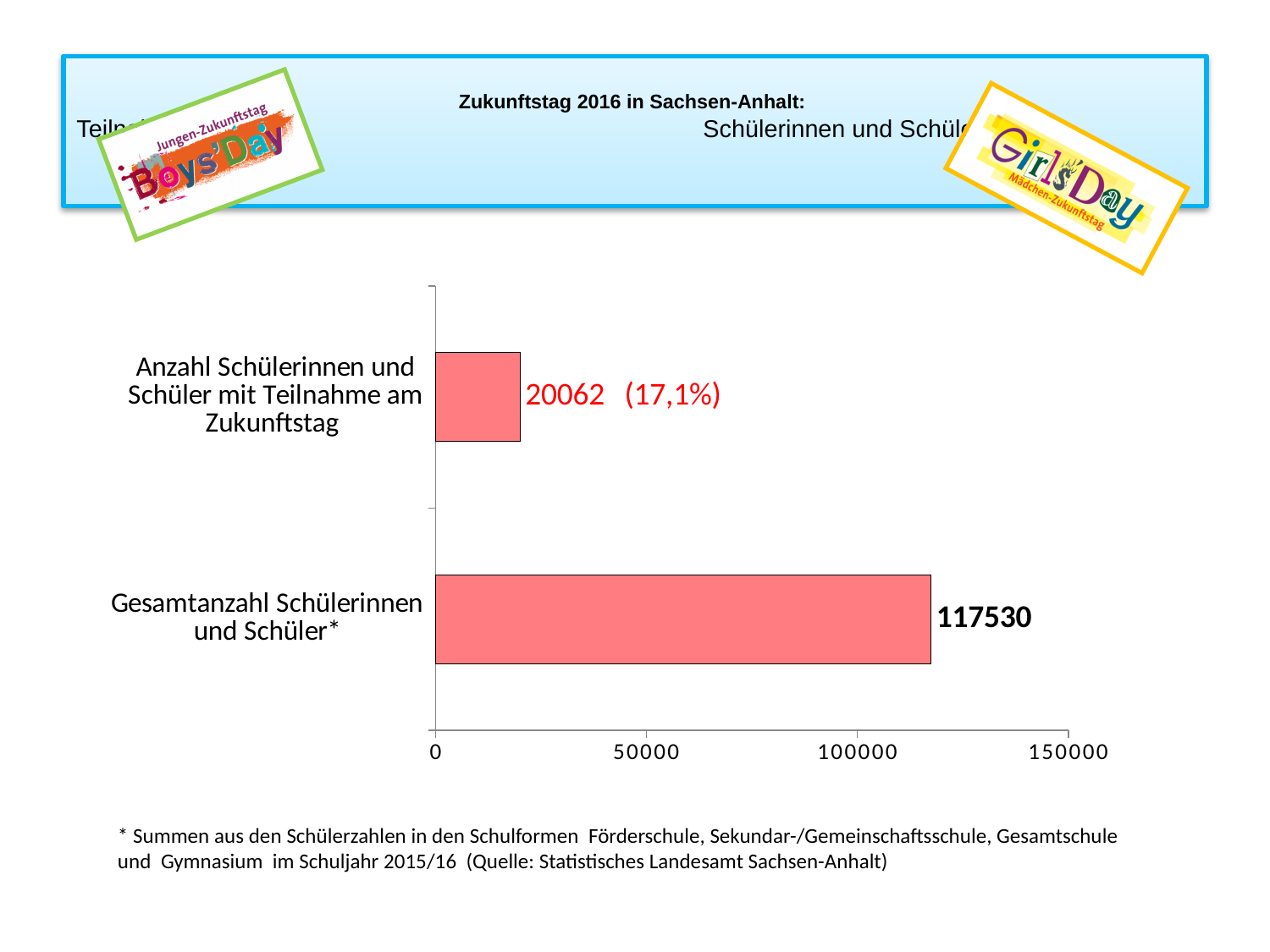
Which category has the highest value? Gesamtanzahl Schülerinnen und Schüler* What is the highest value shown on the horizontal axis of the chart? 150000 What is the value for "Gesamtanzahl Schülerinnen und Schüler*"? 117530 What is the value for "Anzahl Schülerinnen und Schüler mit Teilnahme am Zukunftstag"? 20062 Which category has the lowest value? Anzahl Schülerinnen und Schüler mit Teilnahme am Zukunftstag Which is larger: "Gesamtanzahl Schülerinnen und Schüler*" or "Anzahl Schülerinnen und Schüler mit Teilnahme am Zukunftstag"? Gesamtanzahl Schülerinnen und Schüler* Is the value for "Anzahl Schülerinnen und Schüler mit Teilnahme am Zukunftstag" greater or less than 50000? less What kind of chart is shown on the slide? bar chart What percentage is shown next to the bar for "Anzahl Schülerinnen und Schüler mit Teilnahme am Zukunftstag"? 17,1% What is the difference between "Gesamtanzahl Schülerinnen und Schüler*" and "Anzahl Schülerinnen und Schüler mit Teilnahme am Zukunftstag"? 97468 Is the value for "Gesamtanzahl Schülerinnen und Schüler*" greater or less than 100000? greater How many categories are shown in the chart? 2